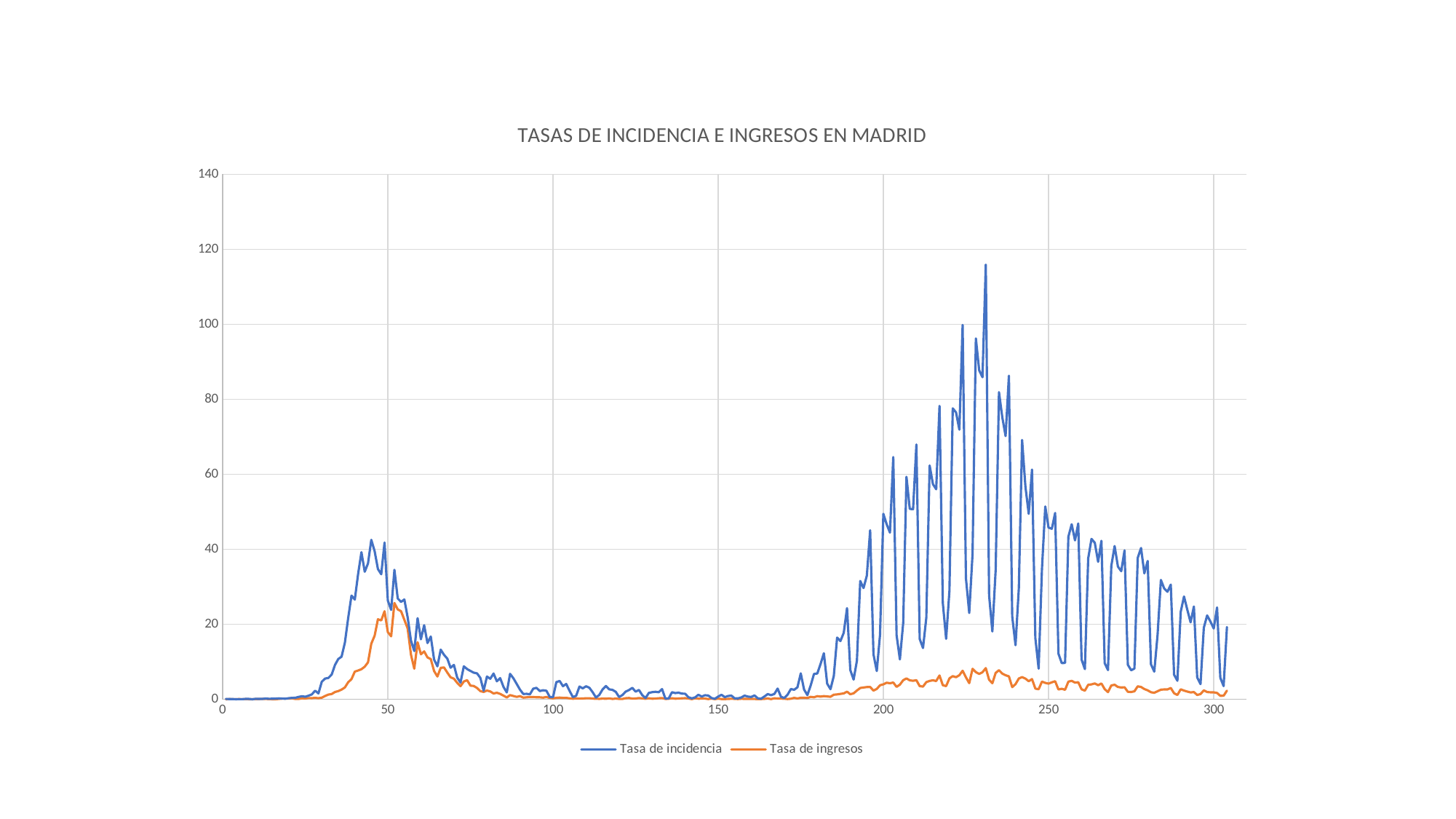
Which series reaches the highest value on the chart? Tasa de incidencia What is the title of the chart? TASAS DE INCIDENCIA E INGRESOS EN MADRID Is the highest peak of Tasa de incidencia greater or less than 100? greater Between x = 170 and x = 230, does Tasa de incidencia generally rise or fall? rise Is the value of Tasa de ingresos at x = 150 greater or less than 20? less Is the highest peak of Tasa de ingresos greater or less than 40? less Between x = 50 and x = 100, does Tasa de incidencia generally rise or fall? fall How many series does the legend list? 2 Which series is drawn in orange? Tasa de ingresos Does the highest peak of Tasa de incidencia occur before or after x = 200? after What kind of chart is shown on the slide? Line chart